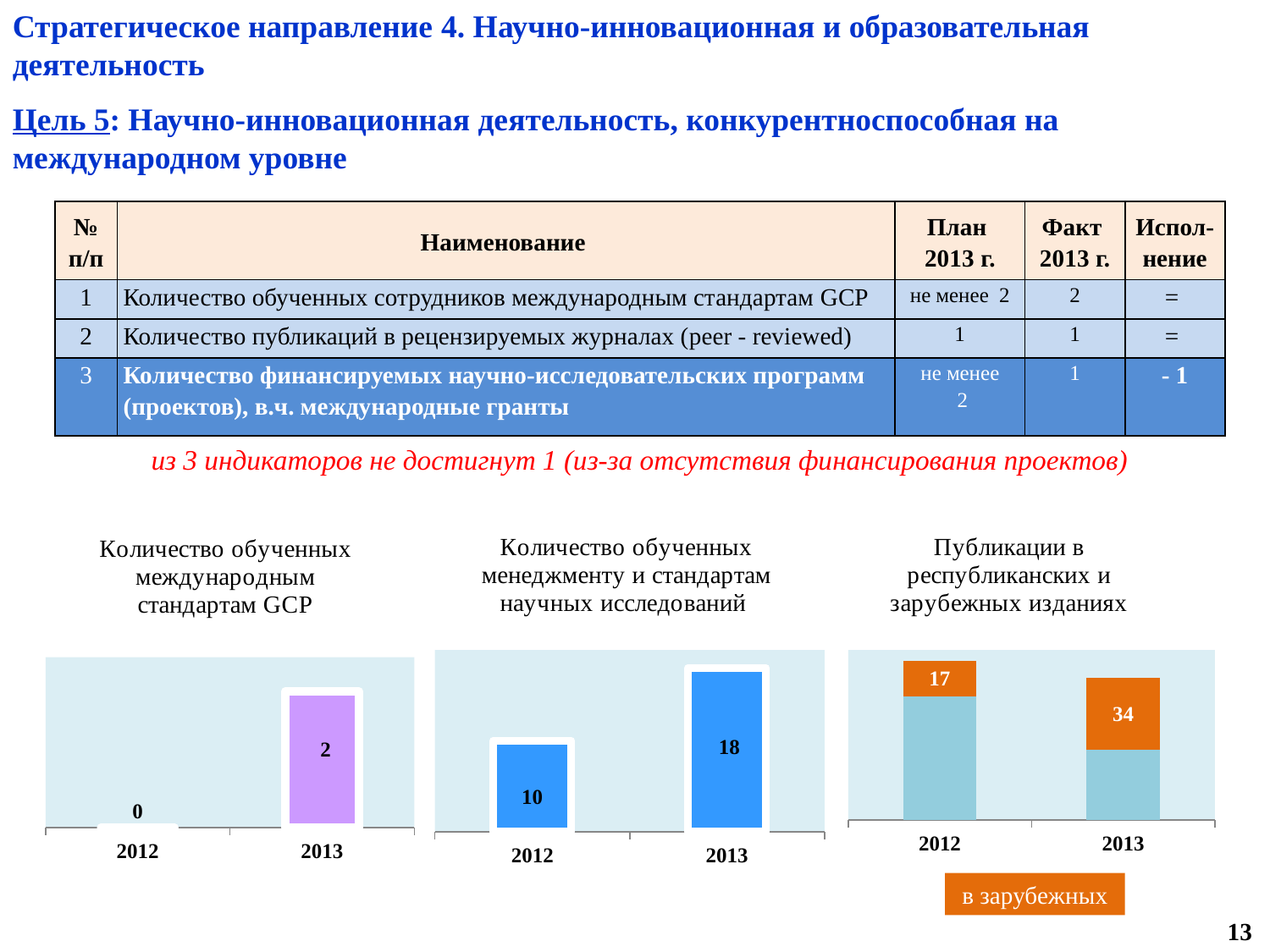
In the chart titled "Публикации в республиканских и зарубежных изданиях", by how much did the "в зарубежных" value increase from 2012 to 2013? 17 In the chart titled "Количество обученных менеджменту и стандартам научных исследований", which year has the higher value? 2013 In the chart titled "Публикации в республиканских и зарубежных изданиях", what is the value of the "в зарубежных" segment for 2012? 17 In the chart titled "Количество обученных менеджменту и стандартам научных исследований", what is the value for 2012? 10 In the chart titled "Количество обученных менеджменту и стандартам научных исследований", what is the value for 2013? 18 In the chart titled "Публикации в республиканских и зарубежных изданиях", is the "в зарубежных" value larger in 2012 or 2013? 2013 How many categories (years) are shown on the x axis of the chart titled "Количество обученных международным стандартам GCP"? 2 In the chart titled "Количество обученных международным стандартам GCP", what is the value for 2012? 0 What type of chart is the chart titled "Количество обученных менеджменту и стандартам научных исследований"? Bar chart In the chart titled "Количество обученных менеджменту и стандартам научных исследований", what is the difference between the 2013 and 2012 values? 8 In the chart titled "Публикации в республиканских и зарубежных изданиях", what is the value of the "в зарубежных" segment for 2013? 34 In the chart titled "Количество обученных международным стандартам GCP", what is the value for 2013? 2